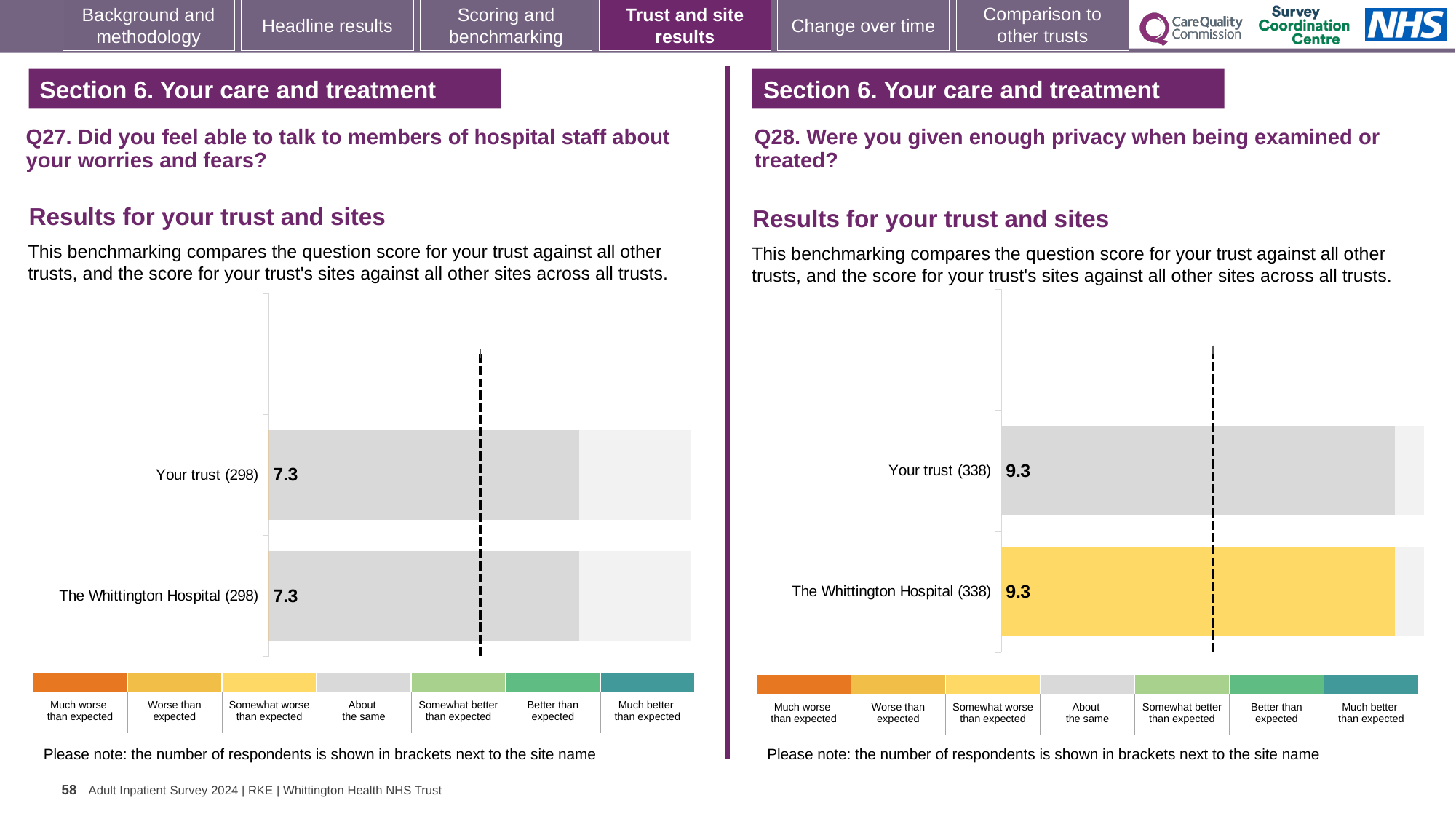
On the Q28 chart (right), what is the score for The Whittington Hospital? 9.3 What kind of chart is the Q27 chart on the left? Bar chart On the Q28 chart (right), what is the score for Your trust? 9.3 On the Q28 chart (right), which benchmark category does the yellow colour of The Whittington Hospital bar correspond to in the key? Somewhat worse than expected On the Q27 chart (left), how many bars are plotted? 2 On the Q27 chart (left), how many respondents are shown in brackets for Your trust? 298 How many categories does the colour key below each chart list? 7 On the Q27 chart (left), what is the score for Your trust? 7.3 On the Q28 chart (right), how many bars are plotted? 2 On the Q28 chart (right), how many respondents are shown in brackets for The Whittington Hospital? 338 On the Q27 chart (left), what is the score for The Whittington Hospital? 7.3 On the Q28 chart (right), what is the difference between the score for Your trust and the score for The Whittington Hospital? 0